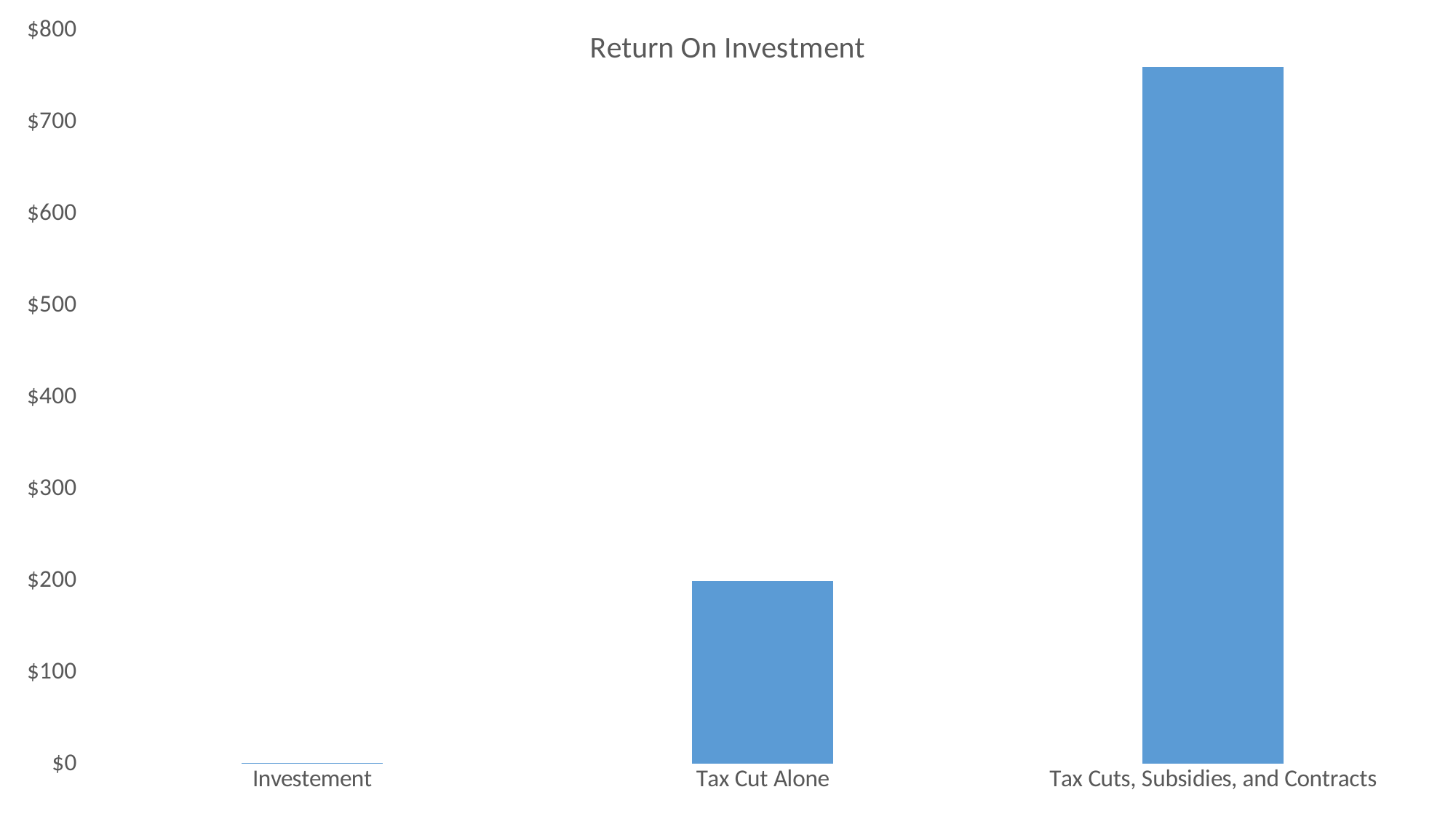
Is the value for Tax Cuts, Subsidies, and Contracts greater or less than $700? greater Which category has the highest value in the chart? Tax Cuts, Subsidies, and Contracts Is the value for Tax Cuts, Subsidies, and Contracts greater or less than $800? less How many categories are shown on the x axis of the chart? 3 Which category has the lowest value in the chart? Investement Which is larger, the value for Tax Cut Alone or the value for Investement? Tax Cut Alone Is the value for Tax Cut Alone greater or less than $100? greater What colour are the bars in the chart? blue What is the title of the chart? Return On Investment What kind of chart is shown on the slide? bar chart Do the values rise or fall moving from left to right along the x axis? rise